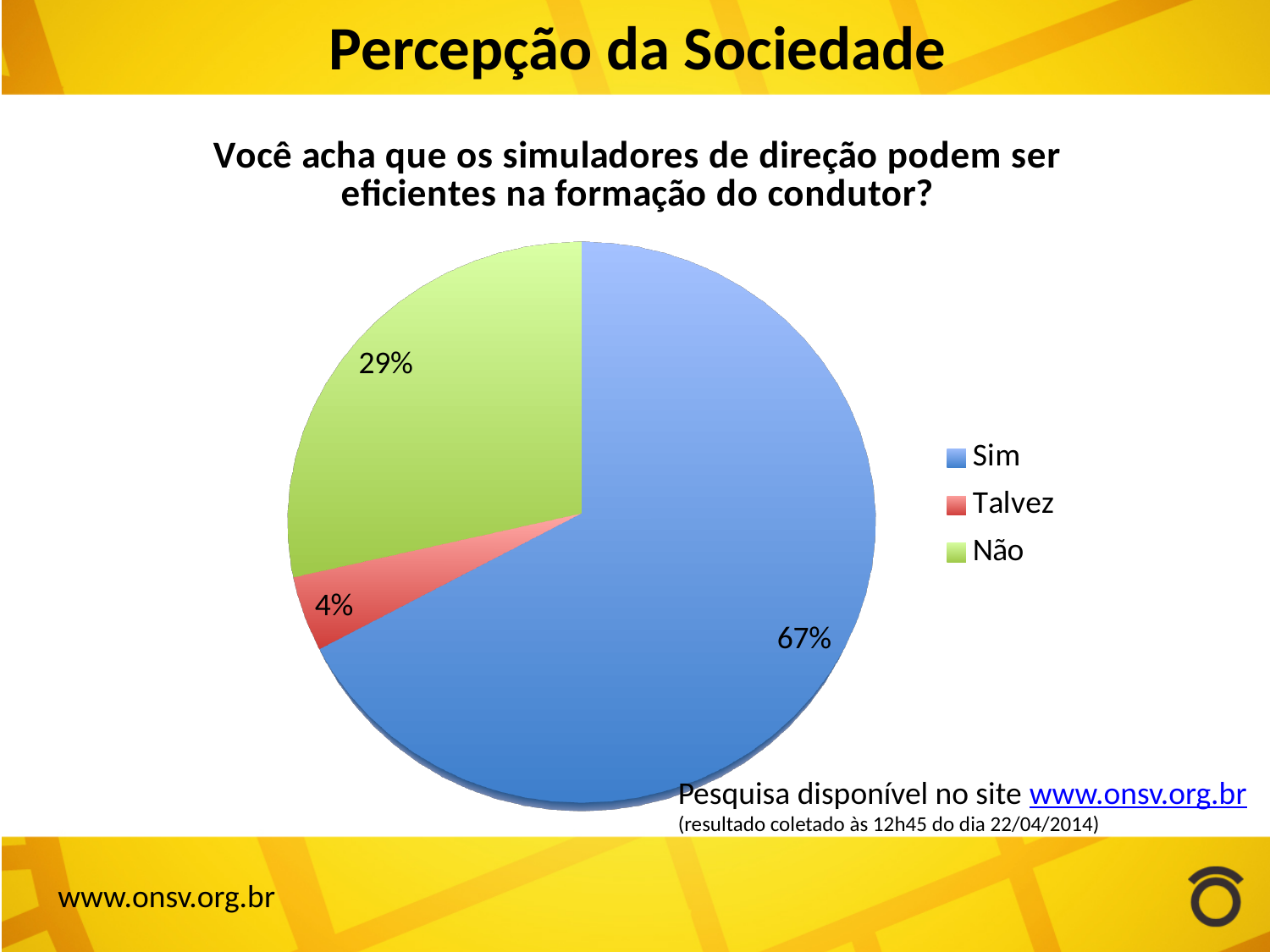
Which is larger, the share for "Não" or the share for "Talvez"? Não What is the difference in percentage points between "Sim" and "Não"? 38 Which response has the smallest share of the pie? Talvez What is the difference in percentage points between "Não" and "Talvez"? 25 What question does the chart title ask? Você acha que os simuladores de direção podem ser eficientes na formação do condutor? What colour is the "Sim" slice in the pie chart? Blue Which response has the largest share of the pie? Sim What percentage of respondents answered "Talvez"? 4% What kind of chart is shown on the slide? Pie chart What percentage of respondents answered "Sim"? 67% How many response categories does the pie chart show? 3 What percentage of respondents answered "Não"? 29%